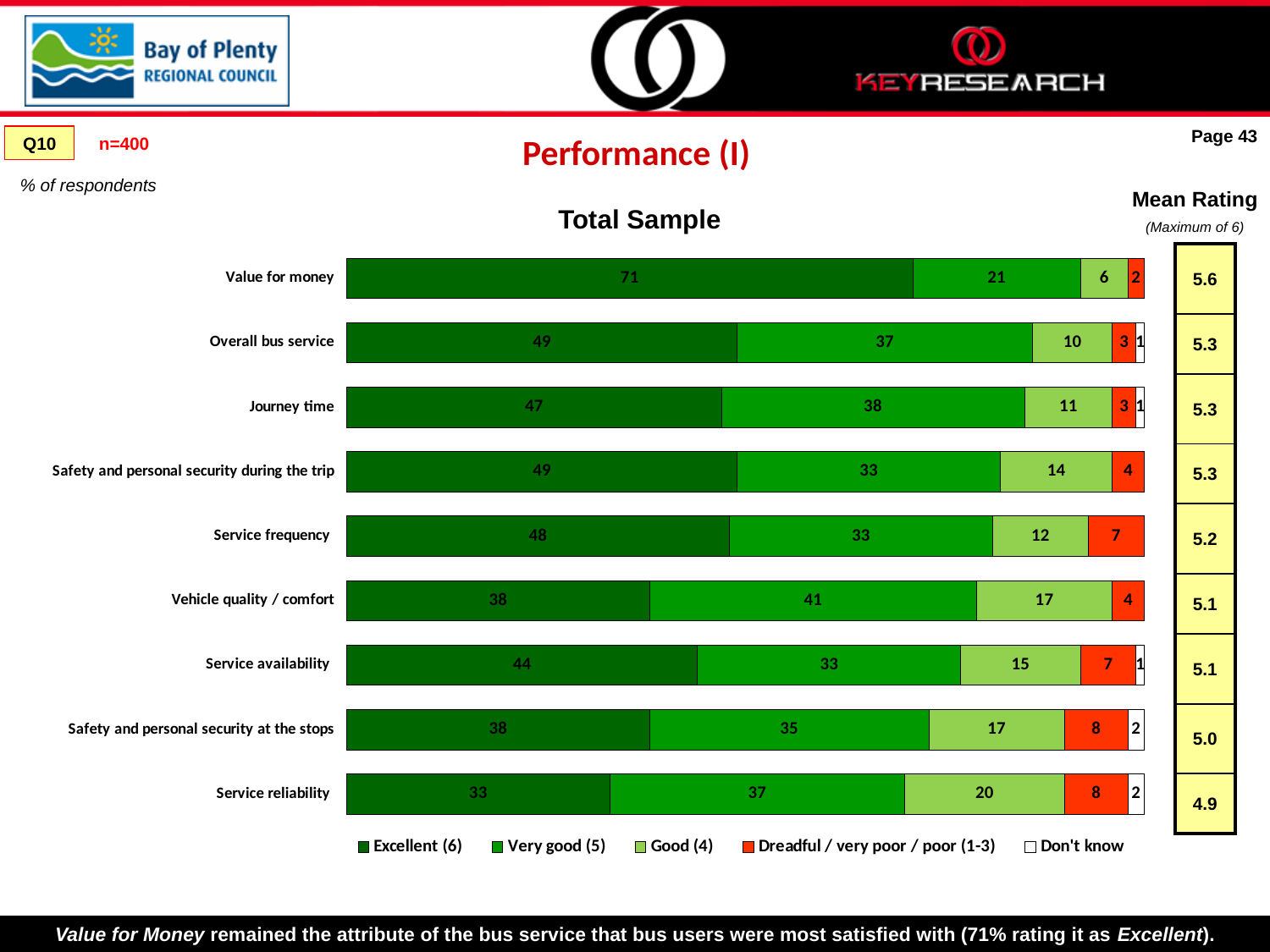
What percentage of respondents rated Service reliability as Good (4)? 20 How much higher is the Excellent (6) percentage for Value for money than for Overall bus service? 22 What type of chart is shown on the slide? Stacked bar chart What percentage of respondents rated Value for money as Excellent (6)? 71 What colour represents the Dreadful / very poor / poor (1-3) series in the legend? Red Which attribute has the lowest Excellent (6) percentage? Service reliability How many series does the legend list? 5 Which has a larger Very good (5) percentage: Vehicle quality / comfort or Journey time? Vehicle quality / comfort What percentage of respondents rated Service frequency as Dreadful / very poor / poor (1-3)? 7 Which attribute has the highest Excellent (6) percentage? Value for money How many attributes (bars) are shown in the chart? 9 What is the Mean Rating shown for Service reliability? 4.9